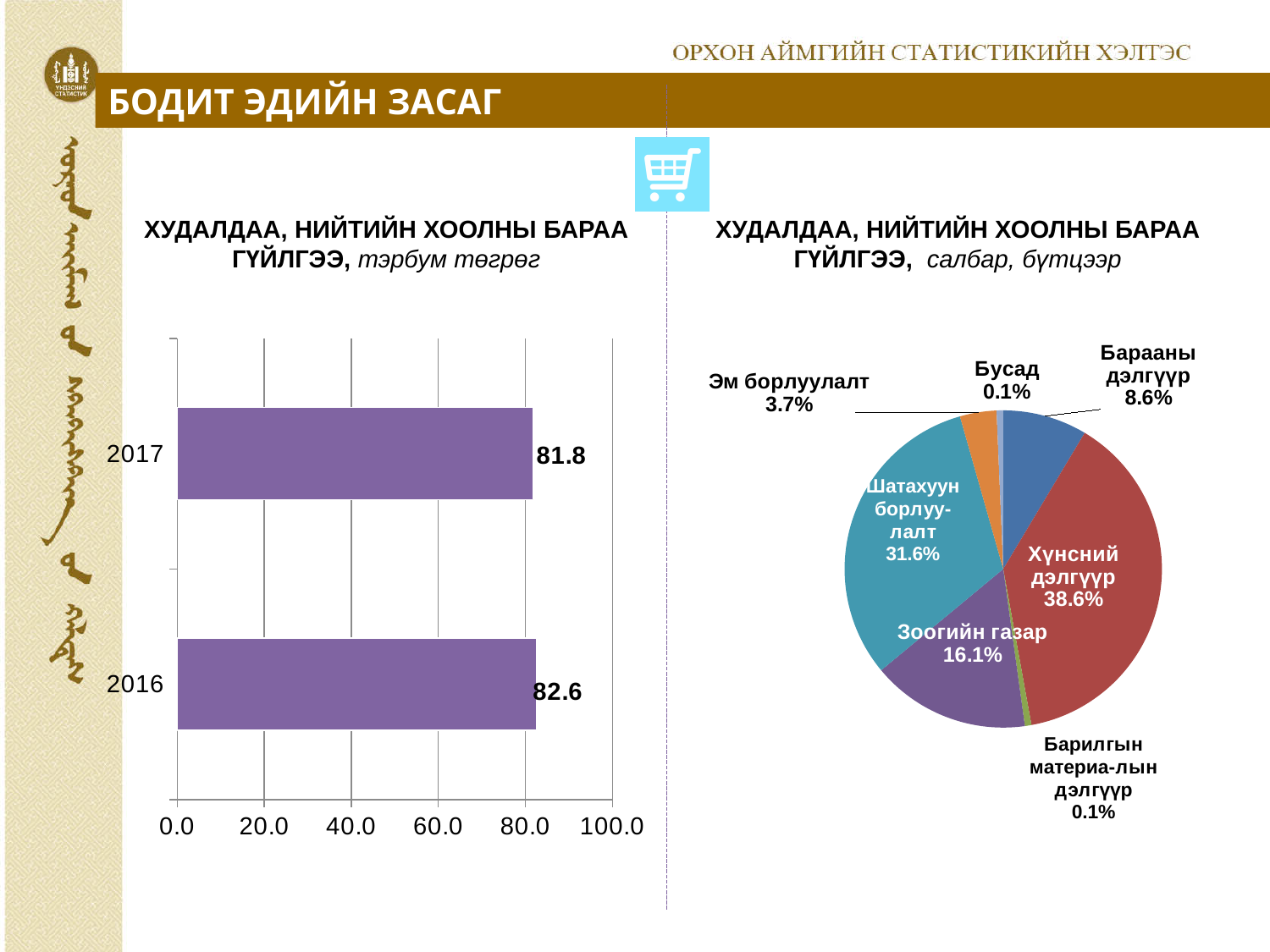
In the left bar chart (ХУДАЛДАА, НИЙТИЙН ХООЛНЫ БАРАА ГҮЙЛГЭЭ, тэрбум төгрөг), what is the value for 2016? 82.6 In the right pie chart, what share does Зоогийн газар have? 16.1% In the left bar chart (ХУДАЛДАА, НИЙТИЙН ХООЛНЫ БАРАА ГҮЙЛГЭЭ, тэрбум төгрөг), what is the value for 2017? 81.8 What type of chart is shown on the right side of the slide? Pie chart How many slices does the right pie chart have? 7 What type of chart is shown on the left side of the slide? Bar chart In the left bar chart, what is the difference between the 2016 and 2017 values? 0.8 In the right pie chart, what share does Шатахуун борлуулалт have? 31.6% How many years are shown in the left bar chart? 2 In the right pie chart, which category has the largest share? Хүнсний дэлгүүр In the right pie chart (ХУДАЛДАА, НИЙТИЙН ХООЛНЫ БАРАА ГҮЙЛГЭЭ, салбар, бүтцээр), what share does Хүнсний дэлгүүр have? 38.6% In the left bar chart, which year has the higher value, 2016 or 2017? 2016